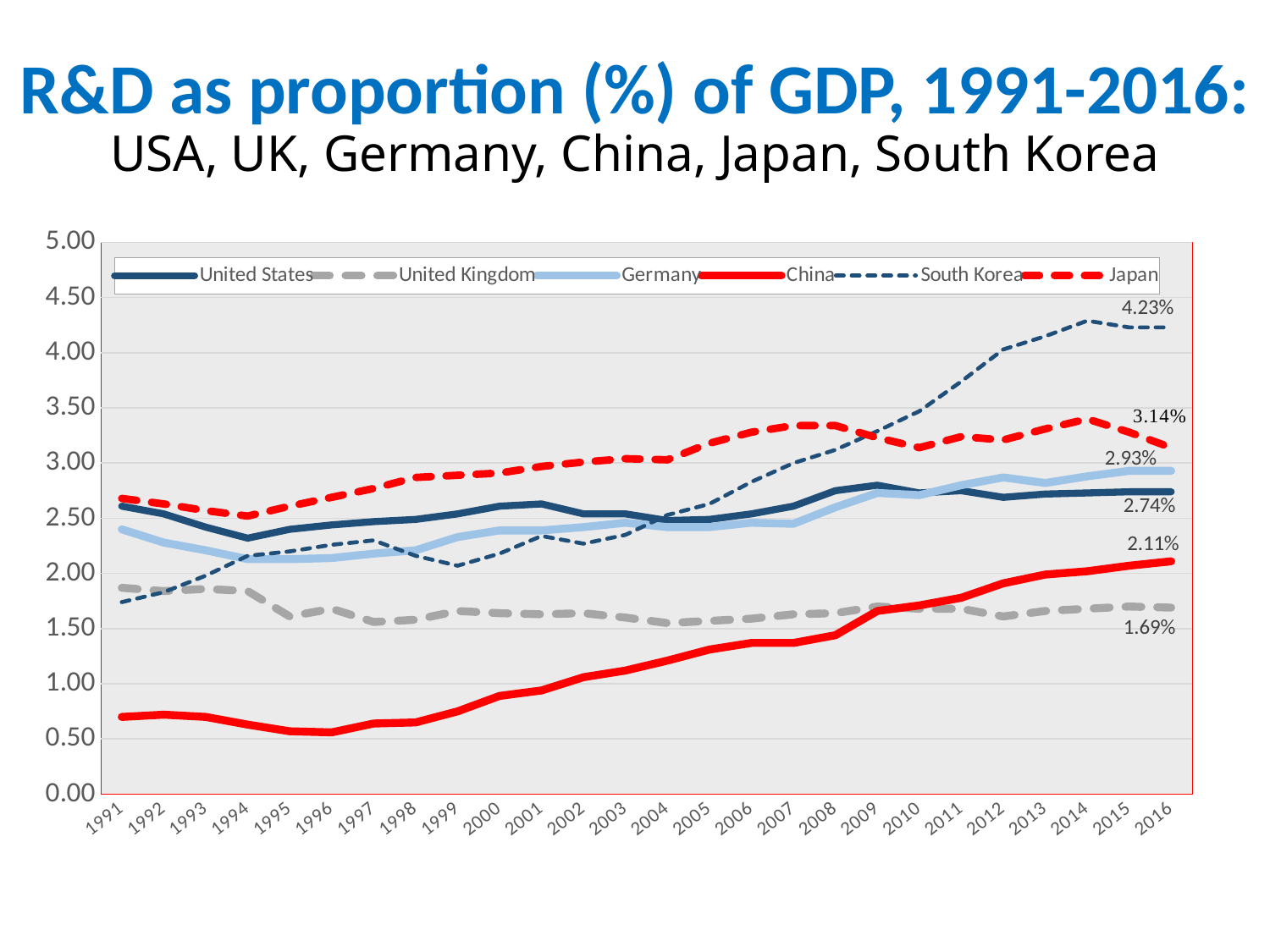
How many series does the legend list? 6 Which country has the lowest R&D as proportion of GDP in 2016? United Kingdom Which country has the highest R&D as proportion of GDP in 2016? South Korea What is the value for Germany in 2016? 2.93% What type of chart is shown on the slide? line chart What is the value for China in 2016? 2.11% What is the difference between South Korea's and Japan's values in 2016? 1.09% Is the value for China in 1991 greater or less than 1.00? less What is the value for South Korea in 2016? 4.23% What is the value for the United Kingdom in 2016? 1.69% Does China's R&D as proportion of GDP rise or fall from 1996 to 2016? rise What is the value for Japan in 2016? 3.14%